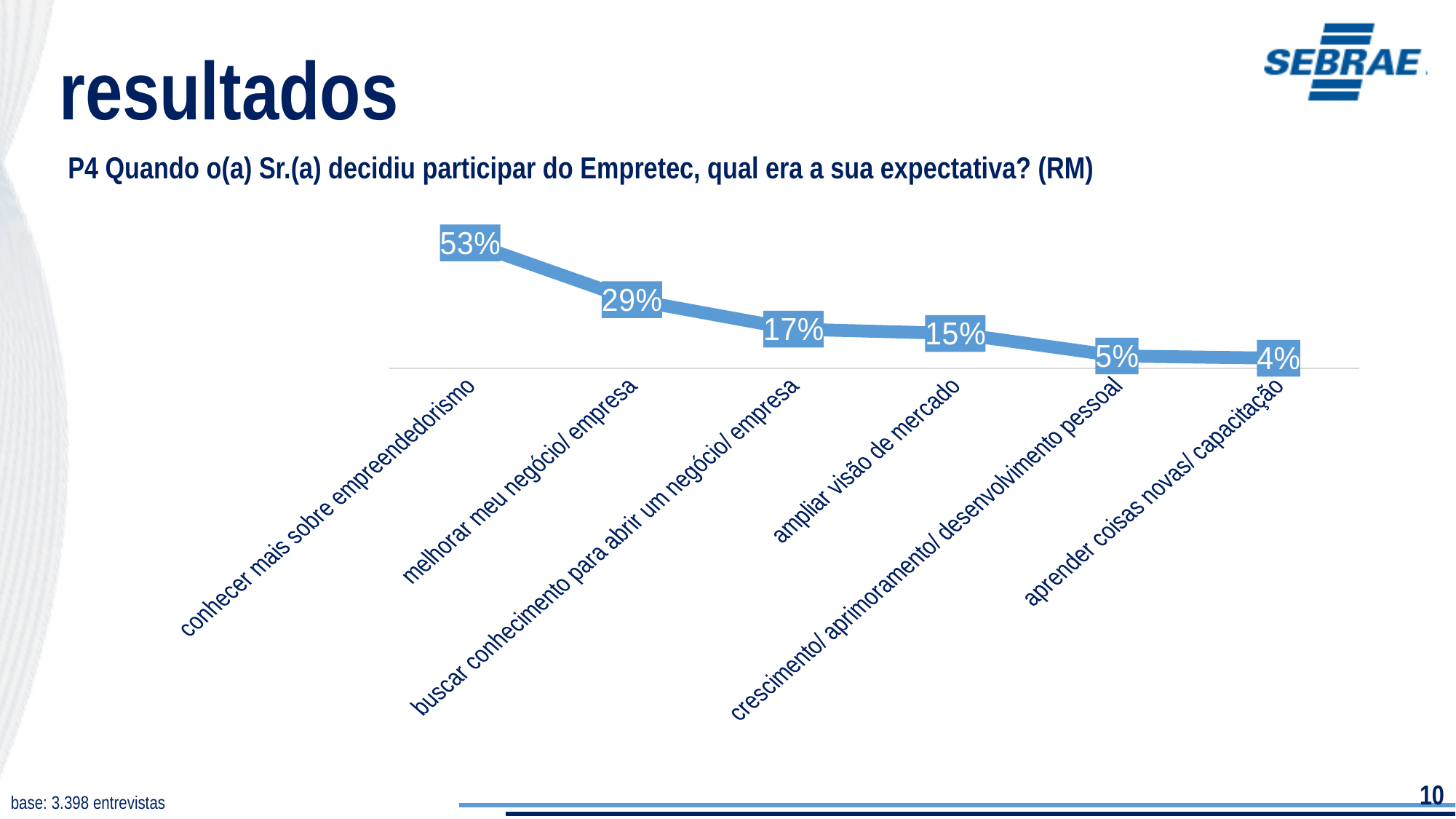
What is the difference between the values for 'conhecer mais sobre empreendedorismo' and 'melhorar meu negócio/ empresa'? 24% How many categories are plotted on the chart? 6 Which category has the lowest value? aprender coisas novas/ capacitação What kind of chart is shown on the slide? line chart What is the value for 'melhorar meu negócio/ empresa'? 29% What is the value for 'conhecer mais sobre empreendedorismo'? 53% Do the values rise or fall from left to right along the x axis? fall What is the value for 'buscar conhecimento para abrir um negócio/ empresa'? 17% What is the value for 'aprender coisas novas/ capacitação'? 4% Which category has the highest value? conhecer mais sobre empreendedorismo What is the value for 'ampliar visão de mercado'? 15% Which is larger: the value for 'ampliar visão de mercado' or for 'crescimento/ aprimoramento/ desenvolvimento pessoal'? ampliar visão de mercado